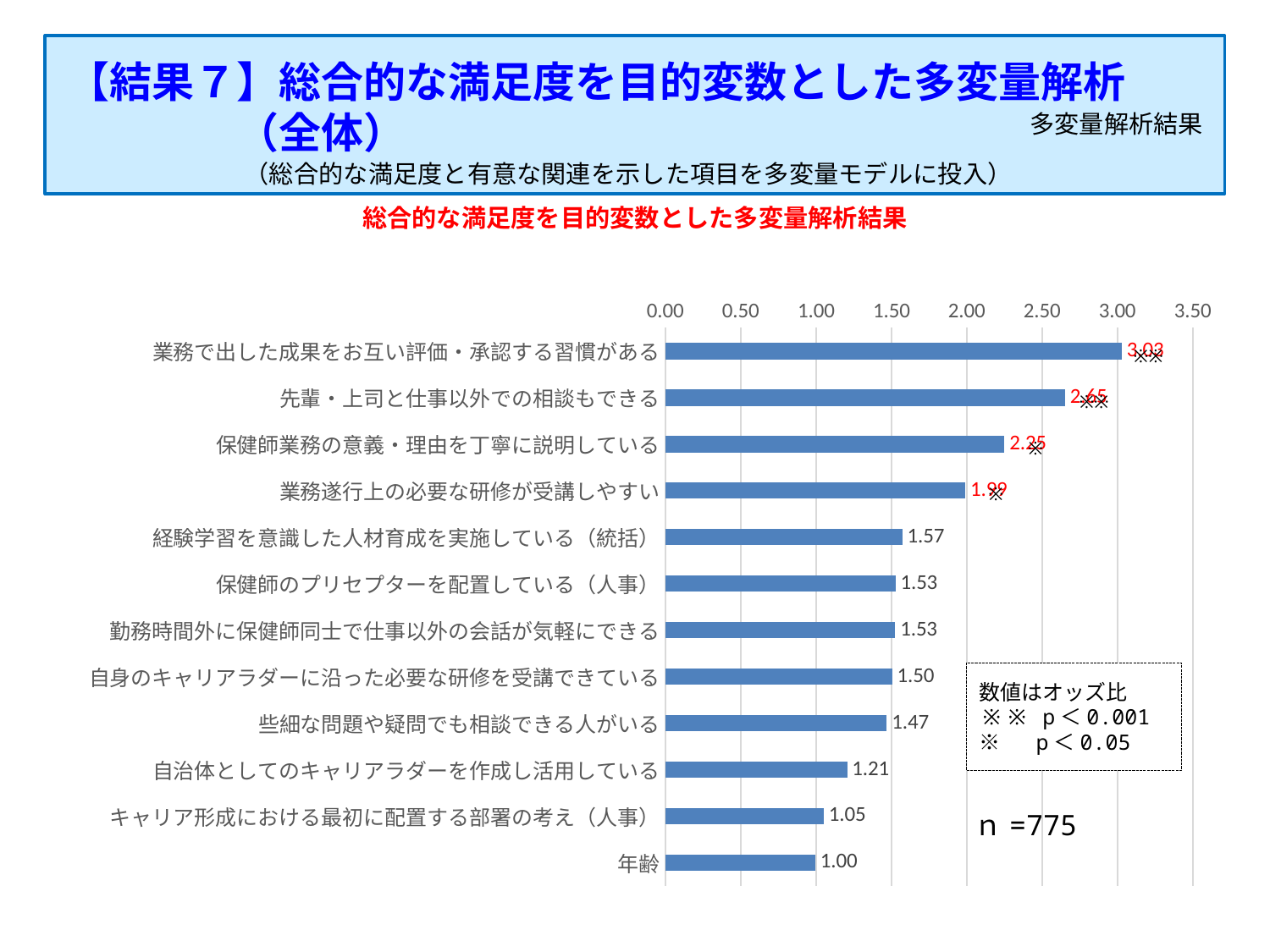
How many categories are shown in the chart? 12 Is the value for 業務で出した成果をお互い評価・承認する習慣がある greater or less than 3.00? greater What is the value for 経験学習を意識した人材育成を実施している（統括）? 1.57 What kind of chart is shown on the slide? bar chart What is the difference between the values for 自身のキャリアラダーに沿った必要な研修を受講できている and キャリア形成における最初に配置する部署の考え（人事）? 0.45 What is the value for 些細な問題や疑問でも相談できる人がいる? 1.47 What is the value for 自治体としてのキャリアラダーを作成し活用している? 1.21 What is the value for 年齢? 1.00 Which category has the lowest value? 年齢 What is the sample size (n) shown on the slide? 775 Which is larger, the value for 先輩・上司と仕事以外での相談もできる or the value for 業務遂行上の必要な研修が受講しやすい? 先輩・上司と仕事以外での相談もできる Which category has the highest value? 業務で出した成果をお互い評価・承認する習慣がある